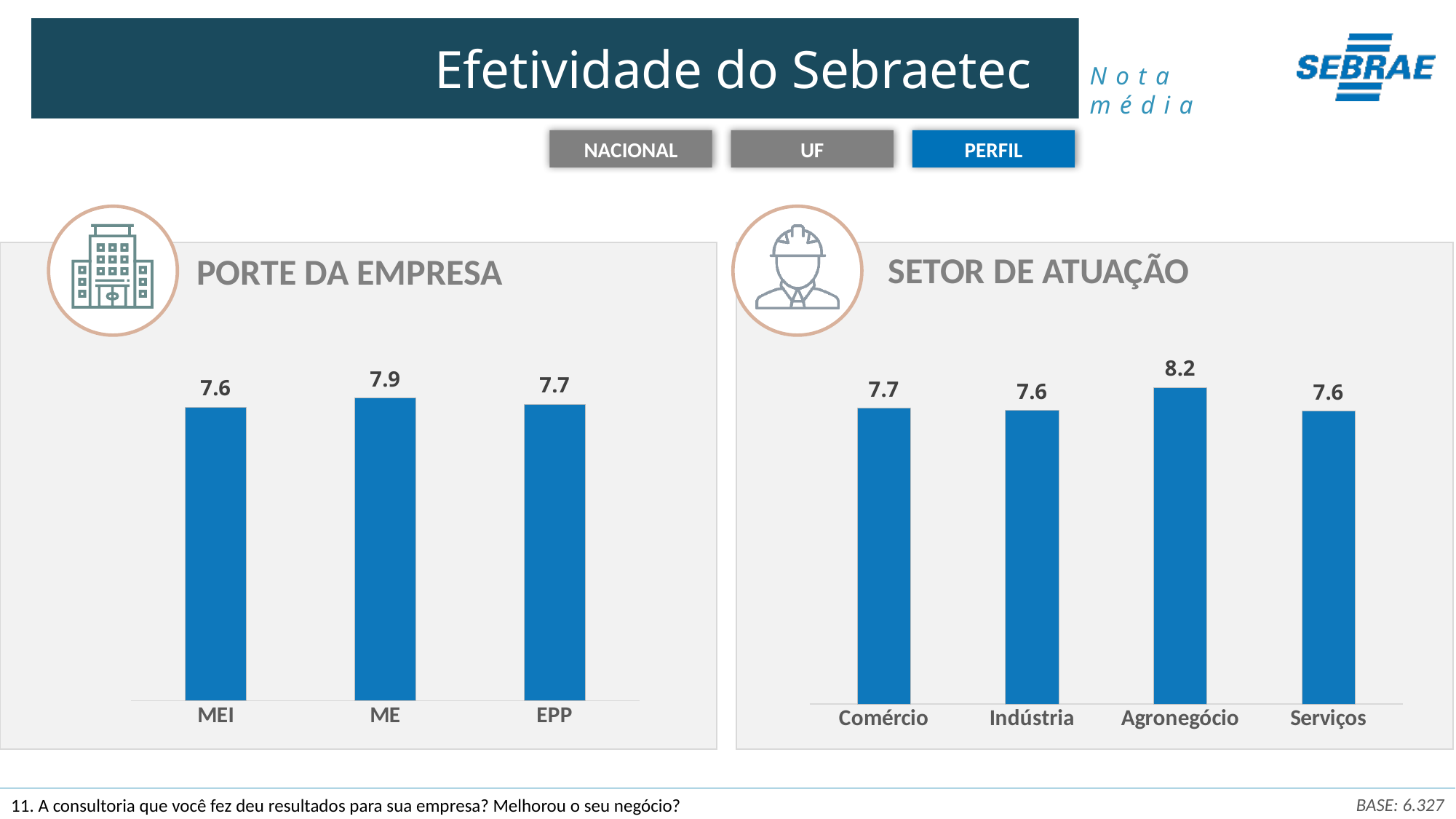
In the PORTE DA EMPRESA chart, which category has the lowest value? MEI In the PORTE DA EMPRESA chart, what is the value for ME? 7.9 In the PORTE DA EMPRESA chart, what is the difference between the values for ME and MEI? 0.3 In the SETOR DE ATUAÇÃO chart, what is the difference between the values for Agronegócio and Indústria? 0.6 In the PORTE DA EMPRESA chart, what is the value for MEI? 7.6 What kind of chart is the SETOR DE ATUAÇÃO chart? Bar chart In the SETOR DE ATUAÇÃO chart, which category has the highest value? Agronegócio In the SETOR DE ATUAÇÃO chart, how many categories are shown? 4 In the SETOR DE ATUAÇÃO chart, what is the value for Agronegócio? 8.2 In the SETOR DE ATUAÇÃO chart, what is the value for Comércio? 7.7 In the PORTE DA EMPRESA chart, how many categories are shown? 3 In the PORTE DA EMPRESA chart, which category has the highest value? ME